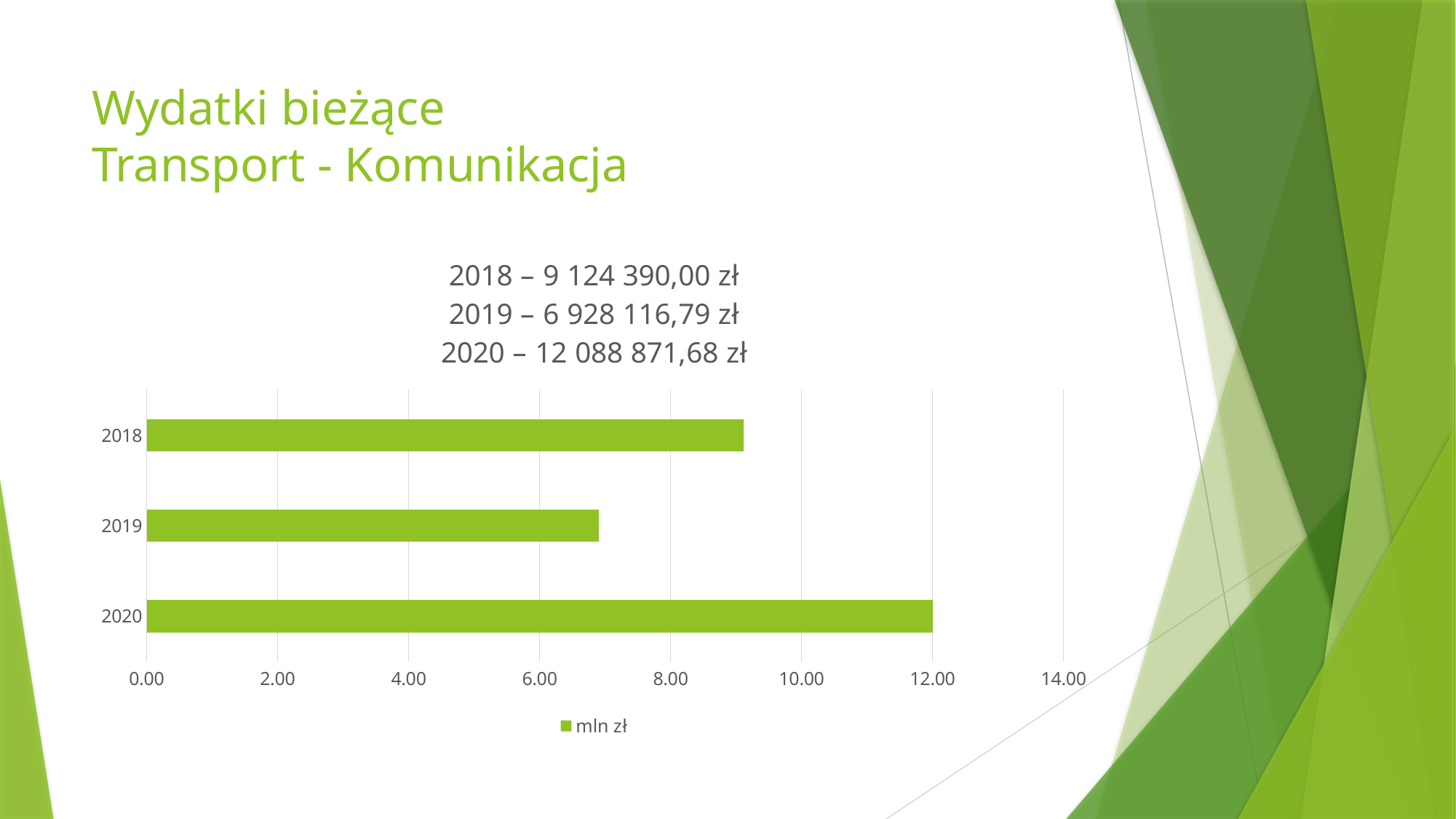
How many years (categories) are plotted in the chart? 3 Is the value for 2019 greater or less than 8.00? less Is the value for 2018 greater or less than 8.00? greater Is the value for 2020 greater or less than 10.00? greater How many series does the chart legend list? 1 Which year has the highest value in the chart? 2020 Did the value fall or rise from 2018 to 2019? fall Which year has the lowest value in the chart? 2019 According to the text on the slide, what was the spending in 2019? 6 928 116,79 zł What kind of chart is shown on the slide? bar chart What is the legend entry of the chart? mln zł Which year has the larger value, 2018 or 2019? 2018